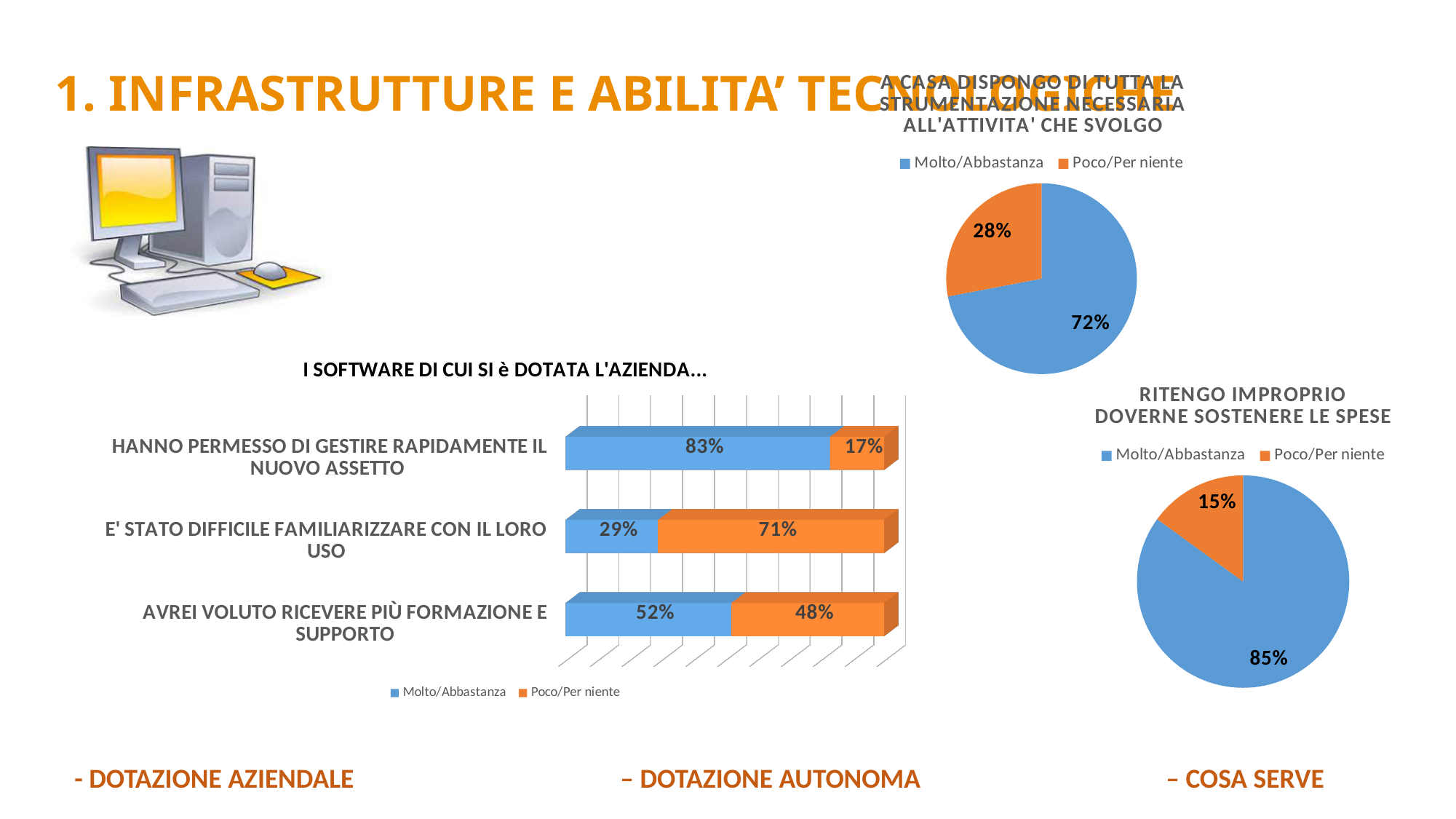
In the chart 'I SOFTWARE DI CUI SI è DOTATA L'AZIENDA...', what is the Molto/Abbastanza value for 'AVREI VOLUTO RICEVERE PIÙ FORMAZIONE E SUPPORTO'? 52% In the chart 'I SOFTWARE DI CUI SI è DOTATA L'AZIENDA...', what is the Molto/Abbastanza value for 'HANNO PERMESSO DI GESTIRE RAPIDAMENTE IL NUOVO ASSETTO'? 83% In the pie chart 'RITENGO IMPROPRIO DOVERNE SOSTENERE LE SPESE', which slice is larger, Molto/Abbastanza or Poco/Per niente? Molto/Abbastanza In the chart 'I SOFTWARE DI CUI SI è DOTATA L'AZIENDA...', what is the Poco/Per niente value for 'E' STATO DIFFICILE FAMILIARIZZARE CON IL LORO USO'? 71% What kind of chart is 'I SOFTWARE DI CUI SI è DOTATA L'AZIENDA...'? Stacked bar chart In the pie chart 'RITENGO IMPROPRIO DOVERNE SOSTENERE LE SPESE', what is the share for Molto/Abbastanza? 85% In the chart 'I SOFTWARE DI CUI SI è DOTATA L'AZIENDA...', how many series does the legend list? 2 In the chart 'I SOFTWARE DI CUI SI è DOTATA L'AZIENDA...', which category has the lowest Poco/Per niente value? HANNO PERMESSO DI GESTIRE RAPIDAMENTE IL NUOVO ASSETTO In the chart 'I SOFTWARE DI CUI SI è DOTATA L'AZIENDA...', what is the difference between the Molto/Abbastanza and Poco/Per niente values for 'E' STATO DIFFICILE FAMILIARIZZARE CON IL LORO USO'? 42% In the chart 'I SOFTWARE DI CUI SI è DOTATA L'AZIENDA...', which category has the highest Molto/Abbastanza value? HANNO PERMESSO DI GESTIRE RAPIDAMENTE IL NUOVO ASSETTO In the chart 'I SOFTWARE DI CUI SI è DOTATA L'AZIENDA...', how many categories are shown? 3 In the pie chart 'A CASA DISPONGO DI TUTTA LA STRUMENTAZIONE NECESSARIA ALL'ATTIVITA' CHE SVOLGO', what is the share for Poco/Per niente? 28%